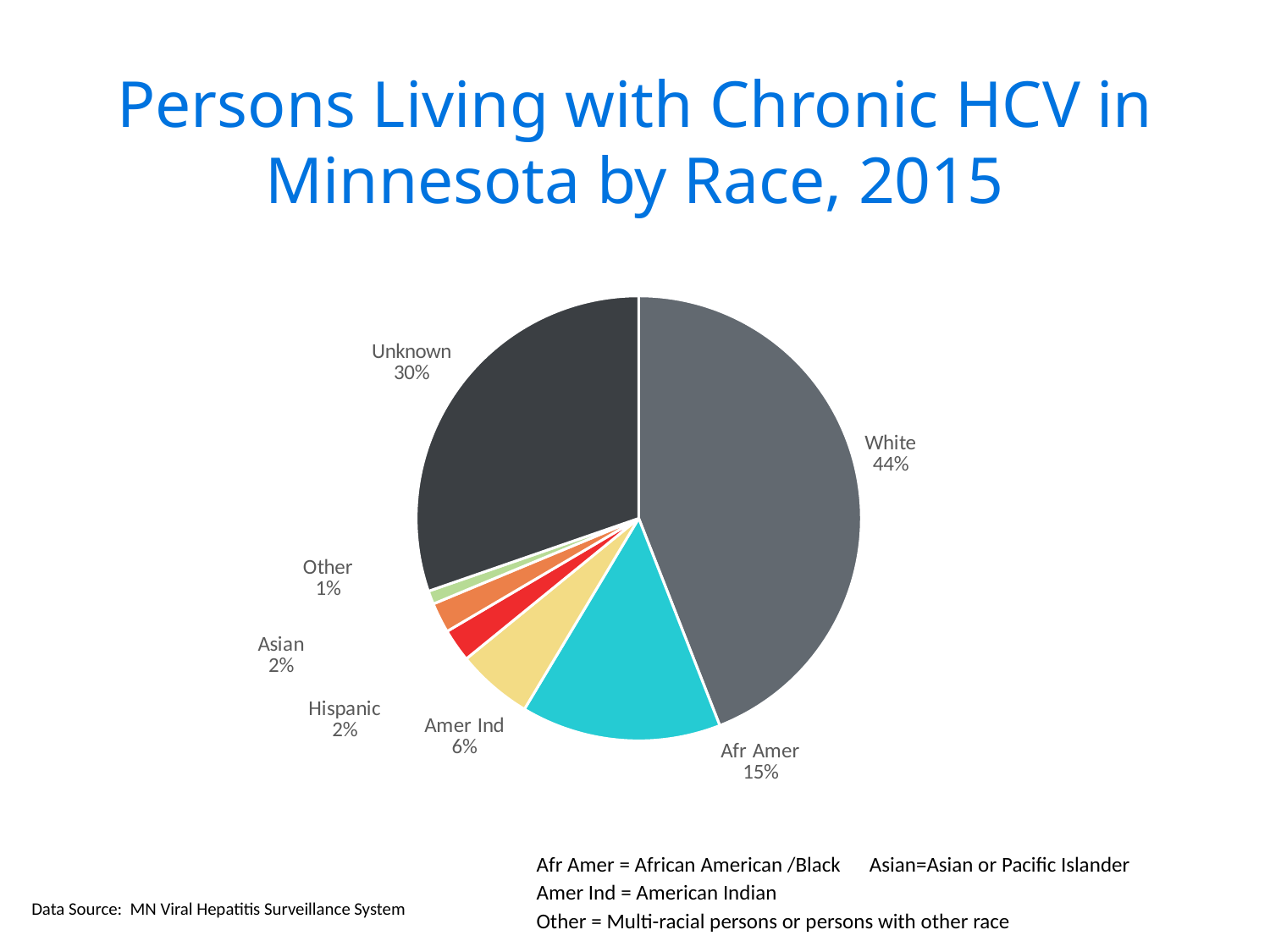
What type of chart is shown on the slide? pie chart Which race category has the largest slice of the pie? White How many categories are shown in the pie chart? 7 What is the value for Amer Ind? 6% What is the difference in percentage points between the White and Unknown slices? 14 What is the data source cited for the chart? MN Viral Hepatitis Surveillance System What is the title of the slide containing the chart? Persons Living with Chronic HCV in Minnesota by Race, 2015 Which is larger, the Afr Amer slice or the Amer Ind slice? Afr Amer What percentage of persons living with chronic HCV in Minnesota are White? 44% Which category has the smallest slice of the pie? Other What share of the pie is labelled Unknown? 30% What is the value for Afr Amer? 15%